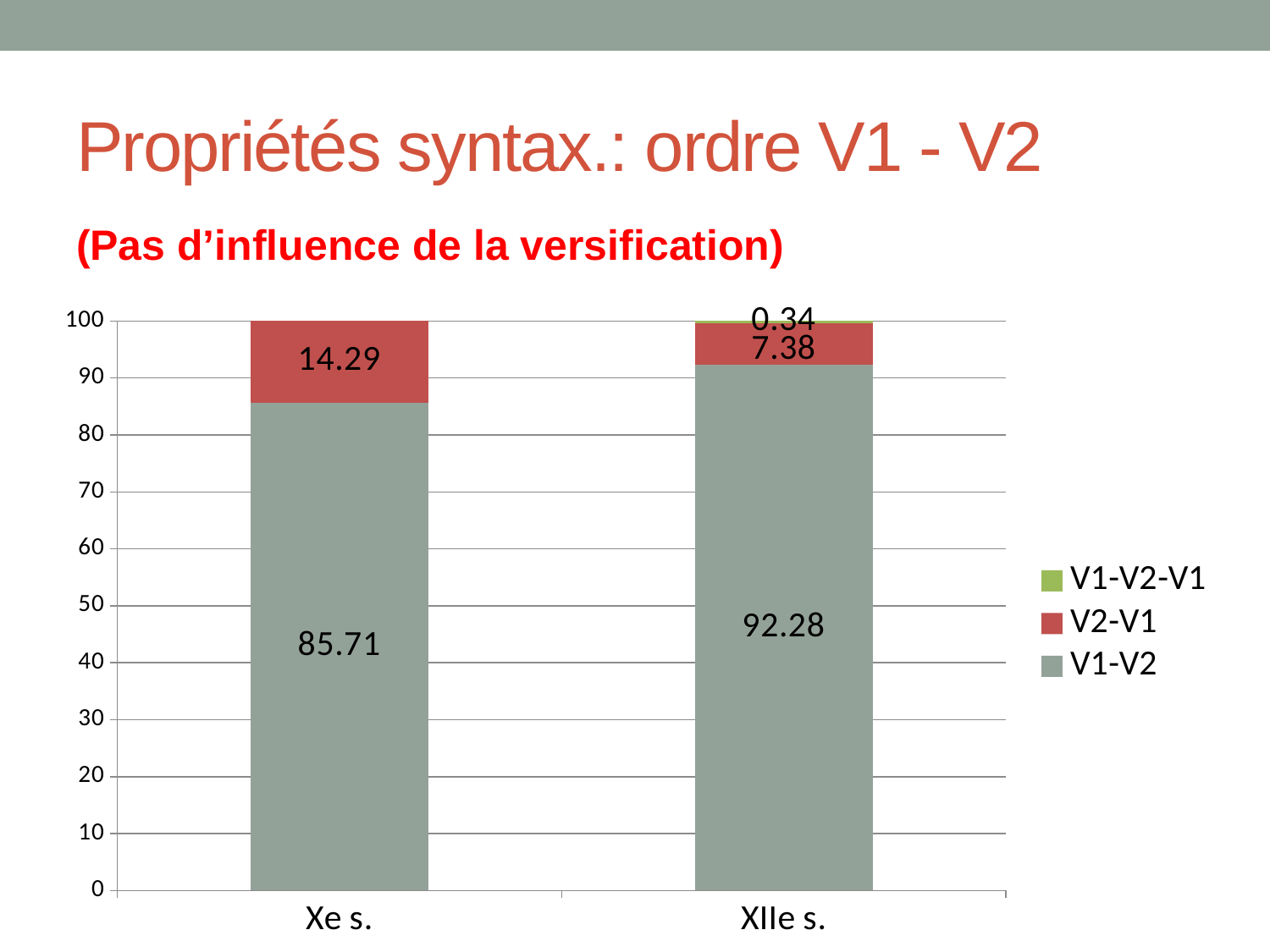
What is the difference between the V2-V1 values for Xe s. and XIIe s.? 6.91 What is the value of V1-V2 for Xe s.? 85.71 What is the total of the stacked bar for XIIe s.? 100 What is the difference between the V1-V2 values for XIIe s. and Xe s.? 6.57 How many categories are shown on the x axis? 2 What is the value of V2-V1 for XIIe s.? 7.38 Which category has the higher V1-V2 value, Xe s. or XIIe s.? XIIe s. How many series does the legend list? 3 What kind of chart is shown on the slide? Stacked bar chart Which category has the lowest V2-V1 value? XIIe s. What is the value of V2-V1 for Xe s.? 14.29 What is the value of V1-V2-V1 for XIIe s.? 0.34